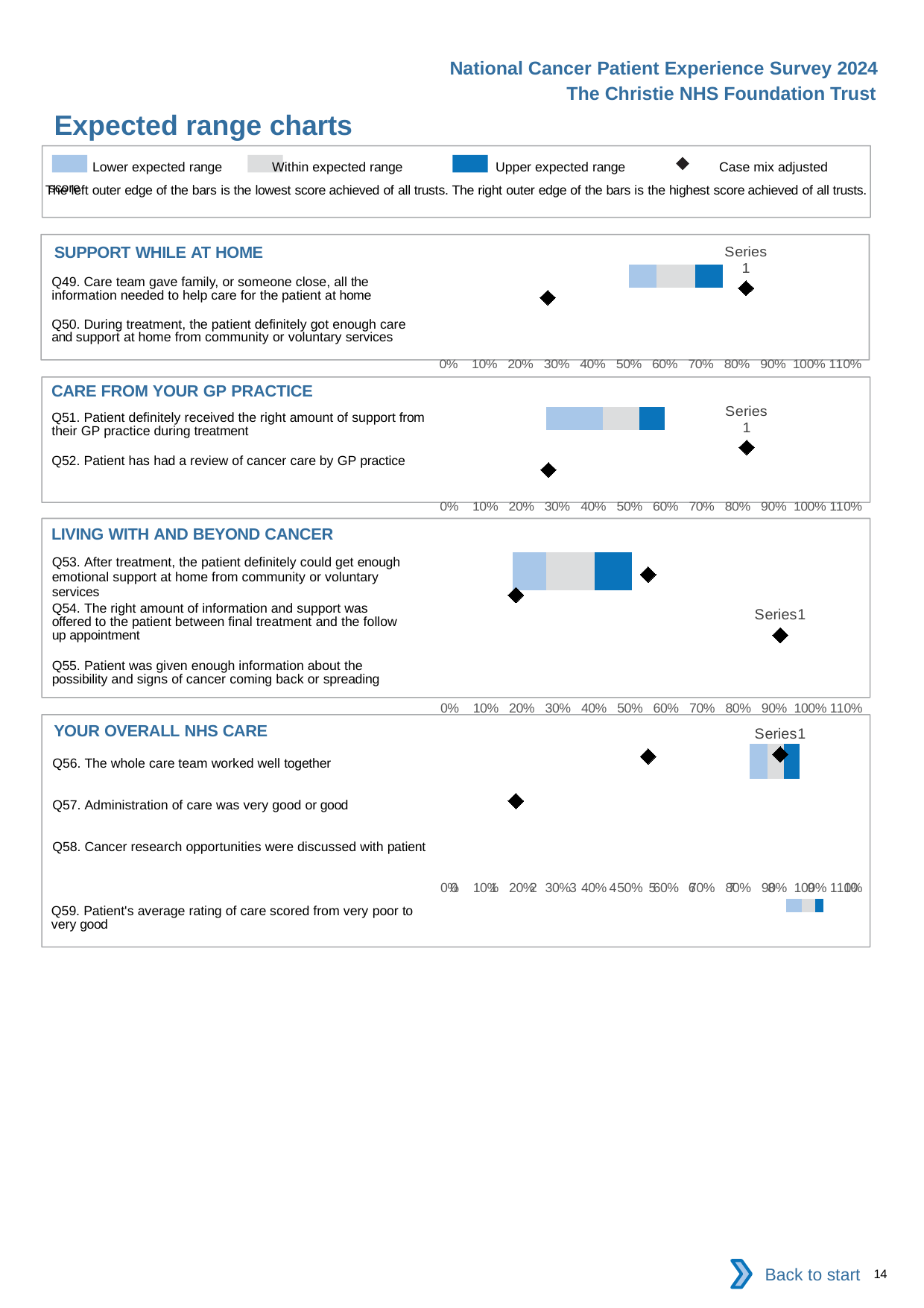
How many questions are listed in the YOUR OVERALL NHS CARE chart? 4 How many questions are listed in the SUPPORT WHILE AT HOME chart? 2 How many entries does the legend at the top of the slide list? 4 What kind of chart is used in the expected range charts on this slide? bar chart How many expected range chart sections are shown on the slide? 4 What is the highest percentage tick shown on the x axis of the charts? 110% According to the legend, what does the black diamond marker represent? Case mix adjusted score In the YOUR OVERALL NHS CARE chart, is the case mix adjusted score for Q56 greater or less than 40%? greater